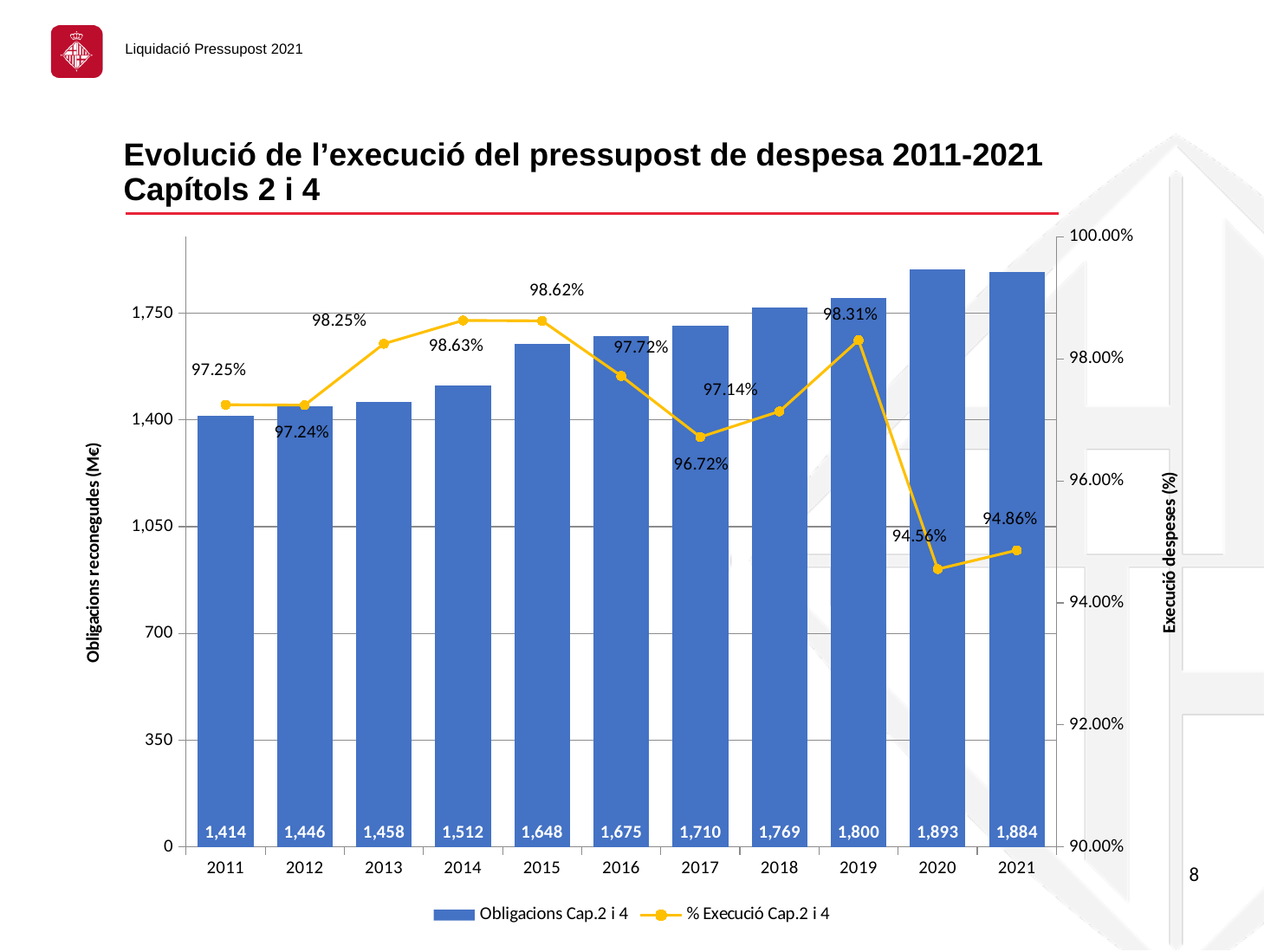
How many years are shown on the x axis? 11 What kind of chart is used to show Obligacions Cap.2 i 4? Bar chart Which year has the lowest value of Obligacions Cap.2 i 4? 2011 What is the difference in Obligacions Cap.2 i 4 between 2021 and 2011? 470 What is the label of the left vertical axis? Obligacions reconegudes (M€) How many series does the legend list? 2 What is the value of Obligacions Cap.2 i 4 for 2015? 1,648 What is the % Execució Cap.2 i 4 for 2020? 94.56% What is the % Execució Cap.2 i 4 for 2014? 98.63% Which year has the lowest % Execució Cap.2 i 4? 2020 Which is larger, the Obligacions Cap.2 i 4 value for 2020 or for 2021? 2020 Which year has the highest value of Obligacions Cap.2 i 4? 2020